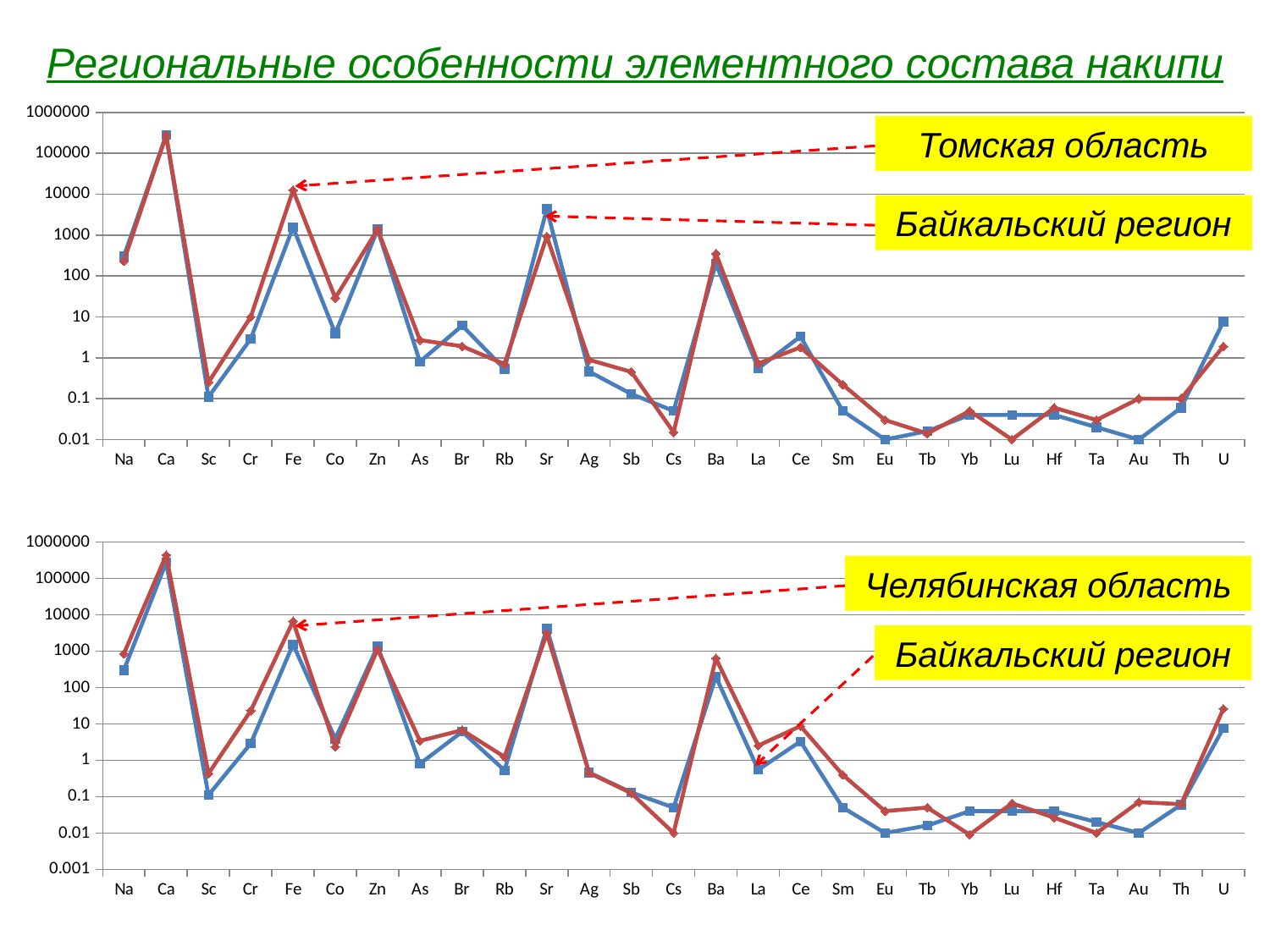
What kind of chart is the top chart on the slide? line chart In the top chart, is the value of Fe for Байкальский регион greater or less than 1000? greater In the bottom chart, is the value of Cr for Челябинская область greater or less than 10? greater What is the lowest value shown on the y axis of the bottom chart? 0.001 How many elements are listed along the x axis of the bottom chart? 27 In the top chart, which series has the larger value at Sr, Томская область or Байкальский регион? Байкальский регион How many series are plotted in the top chart? 2 In the top chart, which series has the larger value at Fe, Томская область or Байкальский регион? Томская область In the top chart, which element has the highest value for Томская область? Ca In the bottom chart, which element has the highest value for Челябинская область? Ca In the bottom chart, which series has the larger value at U, Челябинская область or Байкальский регион? Челябинская область In the top chart, is the value of Co for Томская область greater or less than 10? greater